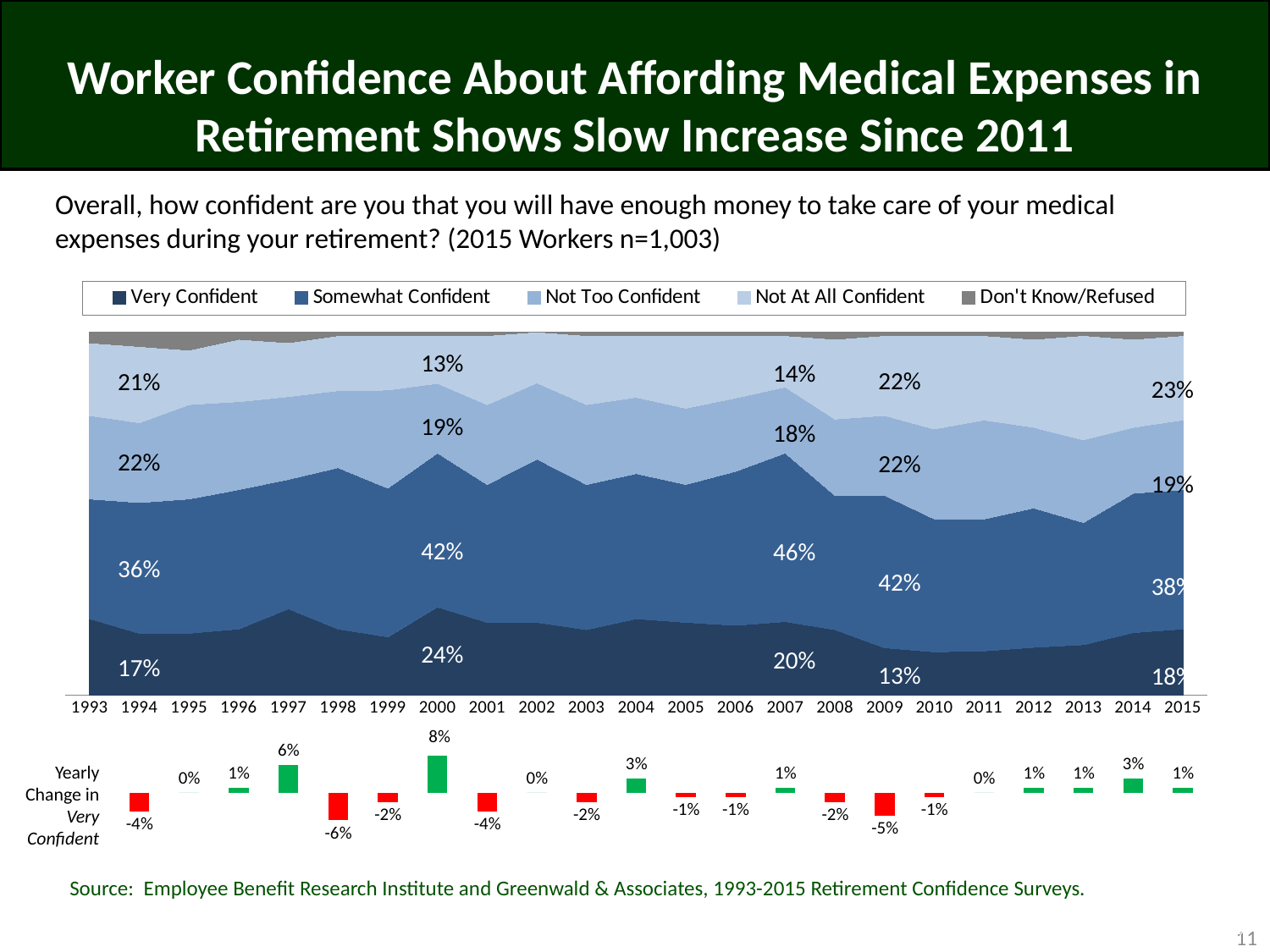
In the stacked area chart, was the Somewhat Confident share larger in 2000 or in 2007? 2007 In the stacked area chart, what percentage of workers were Not Too Confident in 2009? 22% How many years are shown on the x axis of the stacked area chart? 23 In the stacked area chart, what percentage of workers were Somewhat Confident in 2007? 46% In the stacked area chart, what percentage of workers were Not At All Confident in 2000? 13% How many series does the legend of the stacked area chart list? 5 In the Yearly Change in Very Confident bar chart, which year has the largest decrease? 1998 In the stacked area chart, what is the difference between the Very Confident share in 2000 and in 2009? 11% In the Yearly Change in Very Confident bar chart, what is the value for 2009? -5% In the stacked area chart, what percentage of workers were Not At All Confident in 2015? 23% In the Yearly Change in Very Confident bar chart, which year has the largest increase? 2000